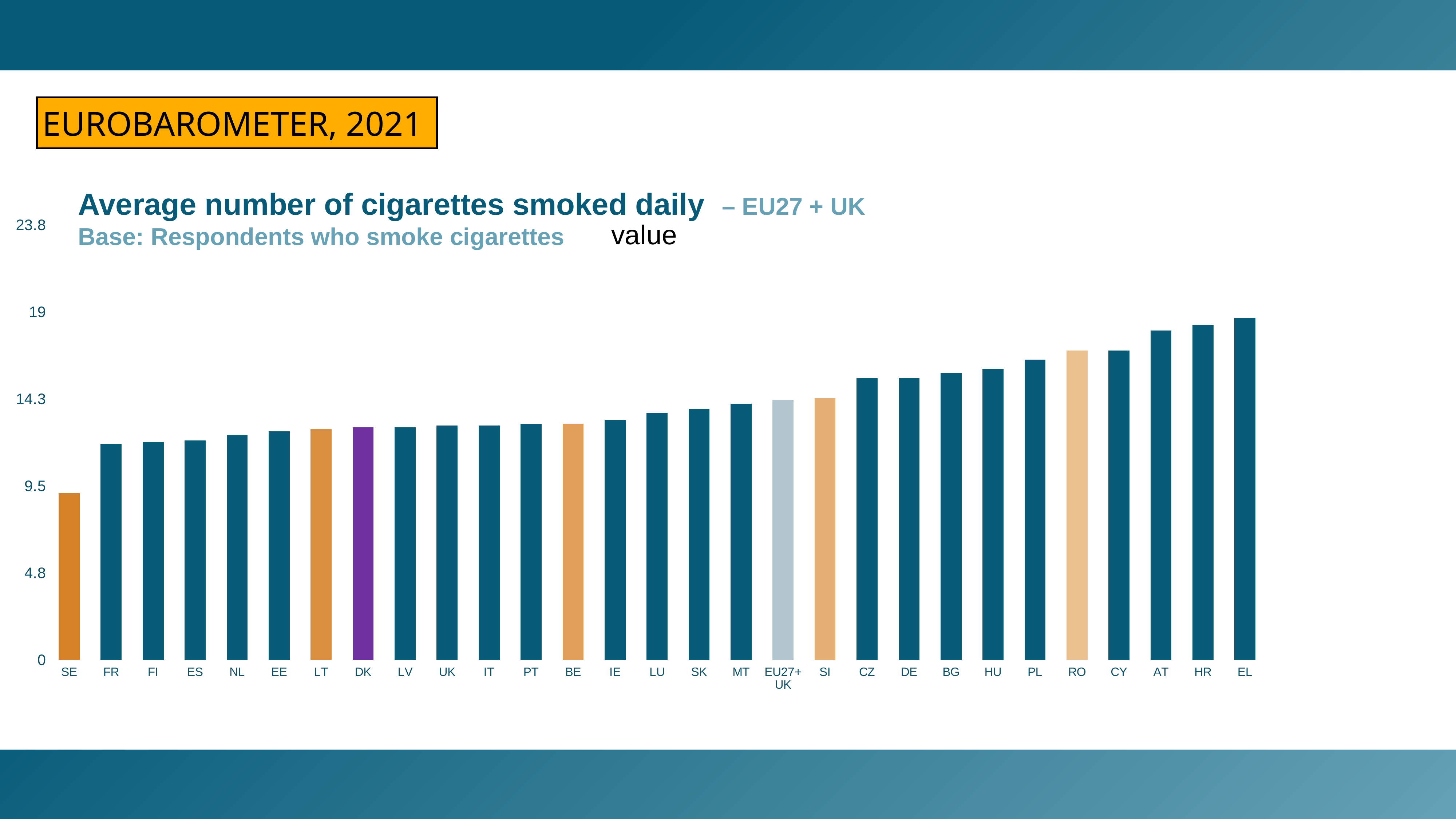
Which category has the highest average number of cigarettes smoked daily? EL Which category has the lowest average number of cigarettes smoked daily? SE Is the value for SE greater or less than 14.3? less Is the value for FR greater or less than 9.5? greater Is the value for CZ greater or less than 14.3? greater Which is larger, the value for AT or the value for FR? AT What is the title of the chart? value How many categories are plotted on the x axis? 29 Do the values rise or fall moving from left to right along the x axis? rise What kind of chart is shown on the slide? bar chart